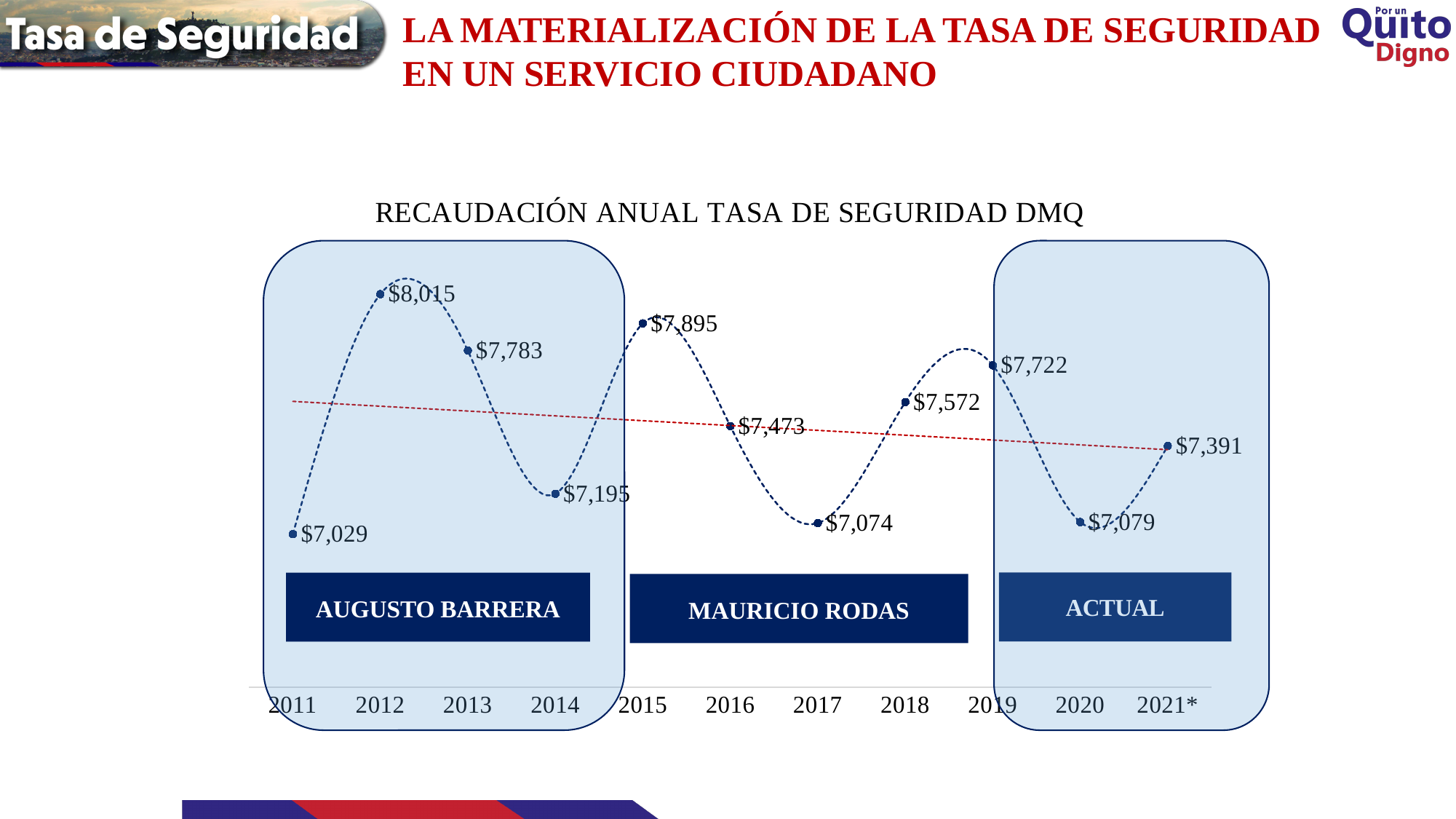
What is the value shown for 2017? $7,074 What kind of chart is shown on the slide? Line chart What is the annual collection value shown for 2012? $8,015 How many years are plotted on the chart? 11 What is the title of the chart? RECAUDACIÓN ANUAL TASA DE SEGURIDAD DMQ Which year has the lowest value on the chart? 2011 Which year has a larger value, 2013 or 2018? 2013 What is the value shown for 2021*? $7,391 What is the difference between the values for 2015 and 2014? $700 Which year has the highest value on the chart? 2012 What is the difference between the values for 2012 and 2011? $986 Which year has a larger value, 2019 or 2016? 2019